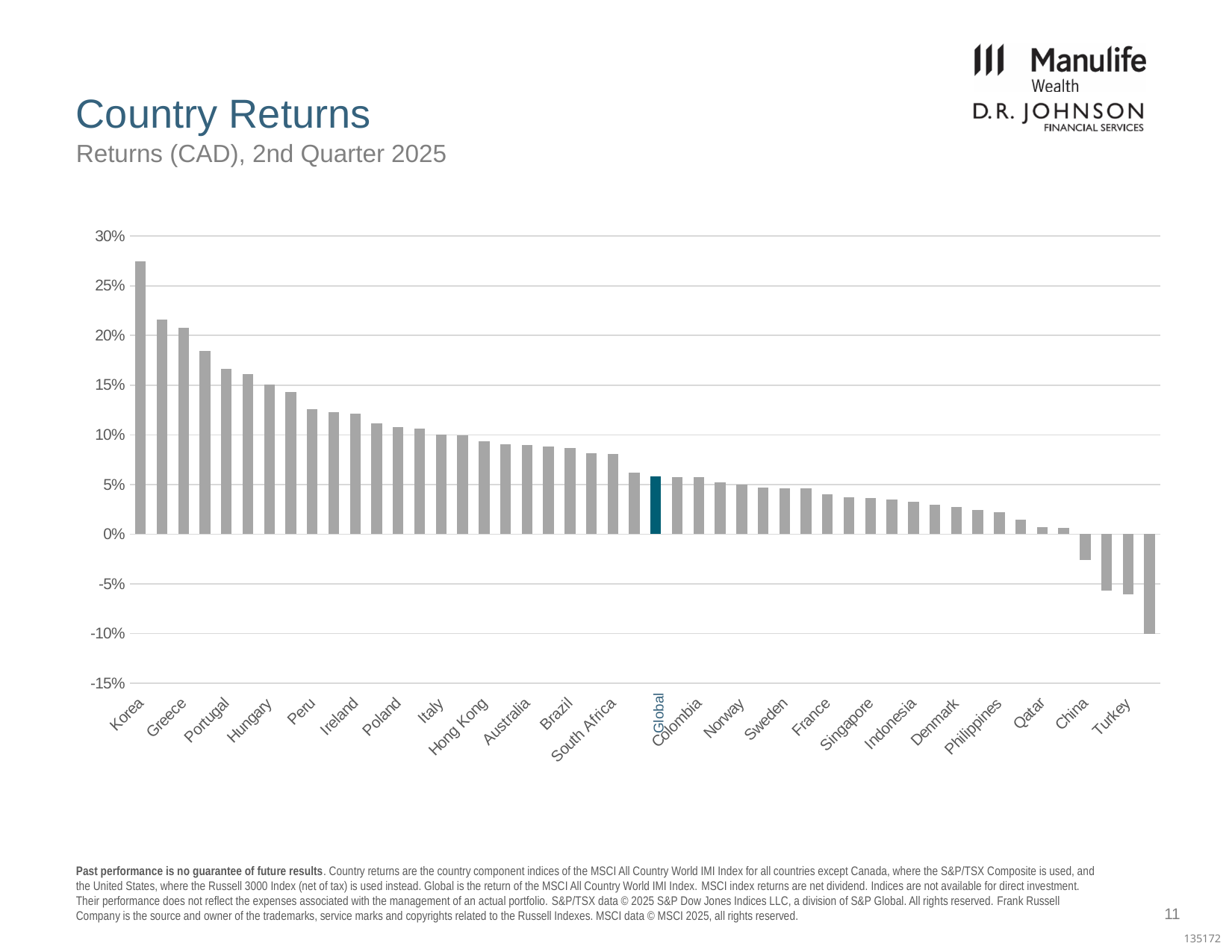
Do the values generally rise or fall moving from left to right along the x axis? fall Is the value for Peru greater or less than 15%? less What kind of chart is shown on the slide? bar chart Is the value for Korea greater or less than 25%? greater Which has the larger return, Korea or Turkey? Korea Is the value for Greece greater or less than 15%? greater Which country has the highest return in the chart? Korea Which bar is highlighted in a different colour from the others? Global